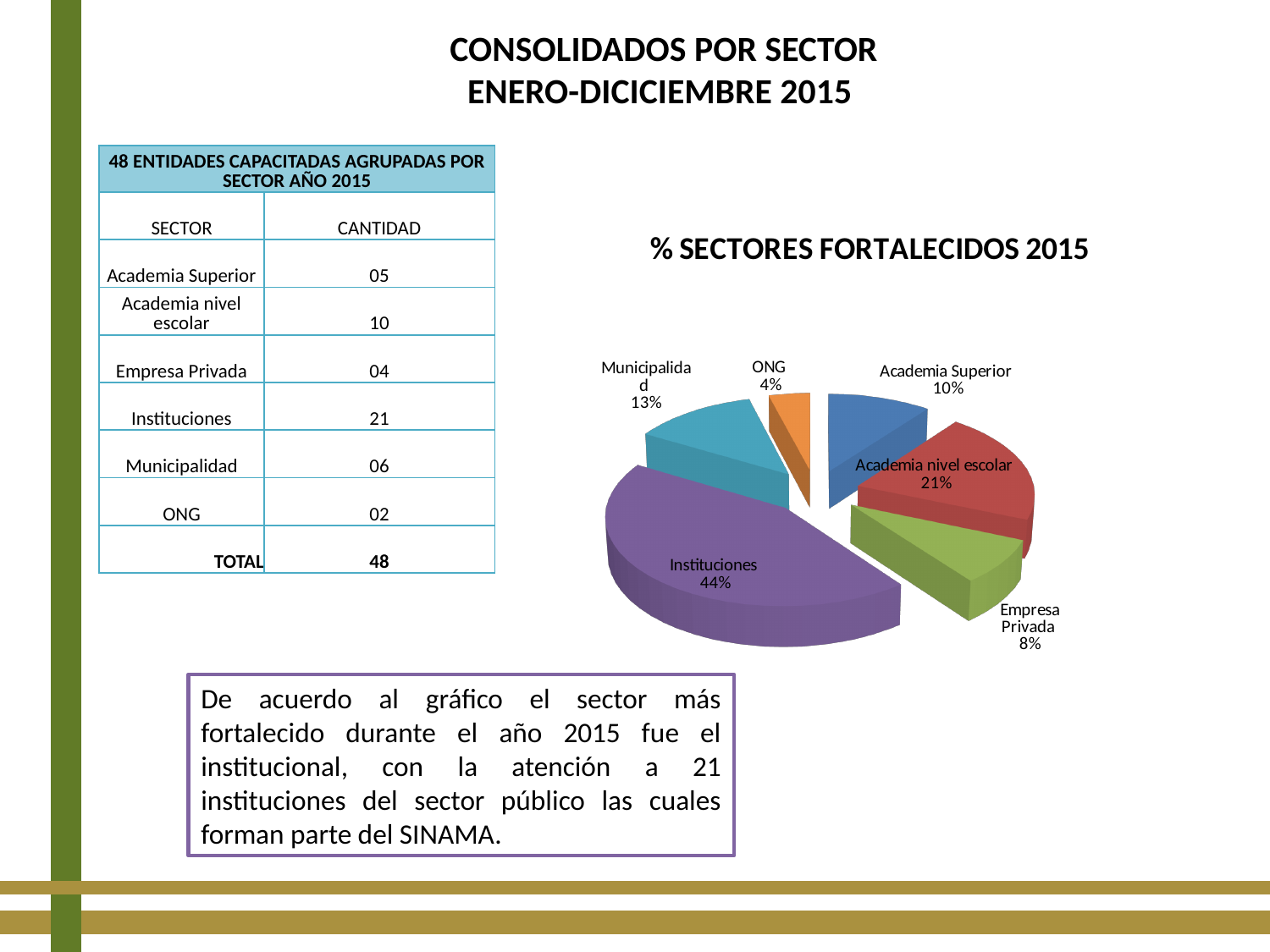
What share of the pie does Empresa Privada represent? 8% What share of the pie does Instituciones represent? 44% What share of the pie does ONG represent? 4% What is the title of the chart? % SECTORES FORTALECIDOS 2015 What kind of chart is shown on the slide? pie chart Which sector has the largest slice of the pie? Instituciones Which is larger, the share for Academia Superior or the share for Empresa Privada? Academia Superior How many slices does the pie chart have? 6 Which sector has the smallest slice of the pie? ONG What is the difference in percentage points between the Instituciones share and the Academia nivel escolar share? 23